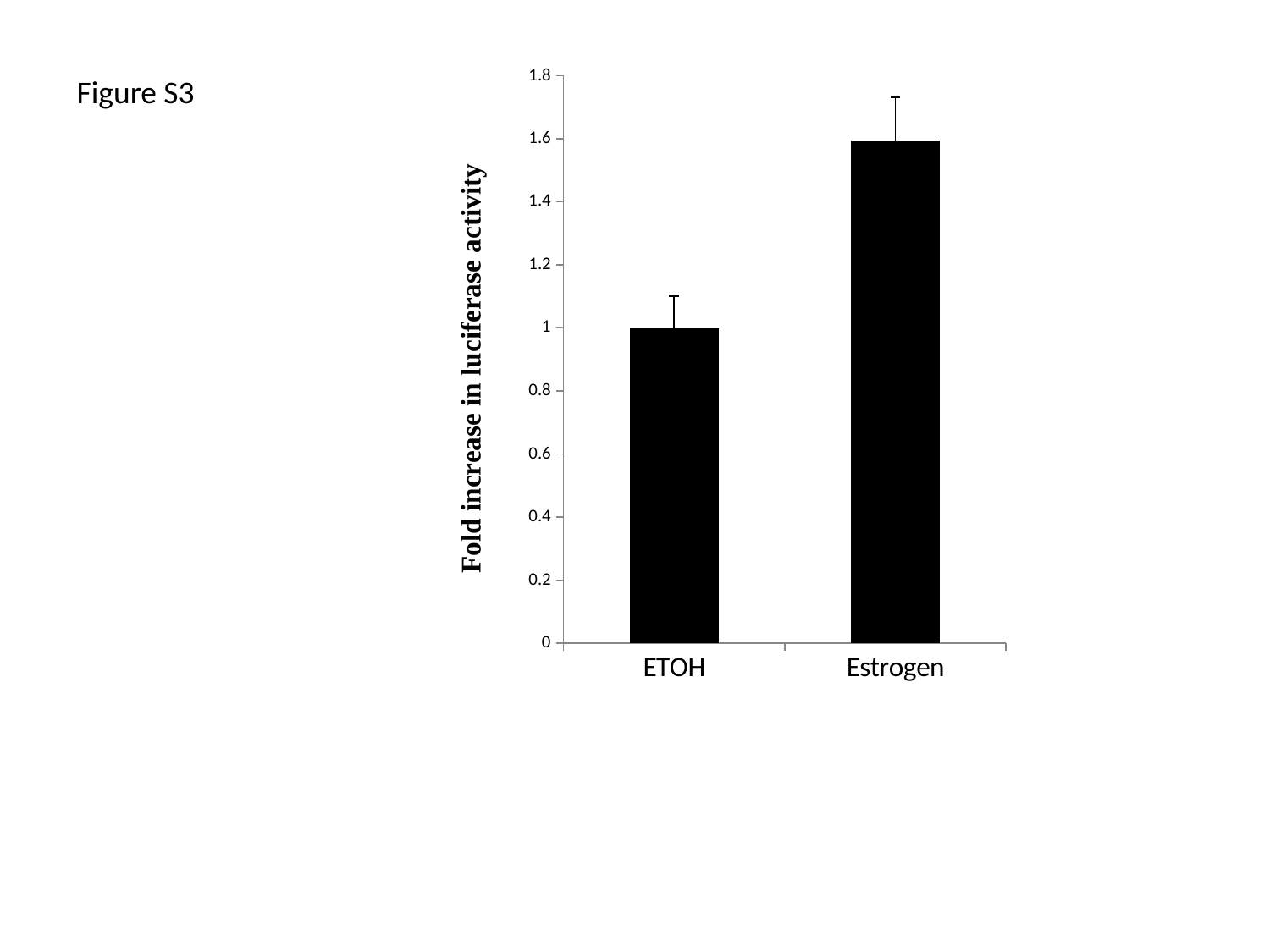
Which category has the lowest fold increase in luciferase activity? ETOH Which category has the highest fold increase in luciferase activity? Estrogen How many bars (categories) are plotted in the chart? 2 What is the fold increase in luciferase activity for ETOH? 1 Is the value for ETOH greater or less than 1.2? less What is the label of the y axis? Fold increase in luciferase activity Which has a larger fold increase in luciferase activity, ETOH or Estrogen? Estrogen What figure label appears at the top left of the slide? Figure S3 What kind of chart is shown on the slide? bar chart Is the value for Estrogen greater or less than 1.4? greater Do the values rise or fall going from ETOH to Estrogen along the x axis? rise Is the value for Estrogen greater or less than 1.8? less